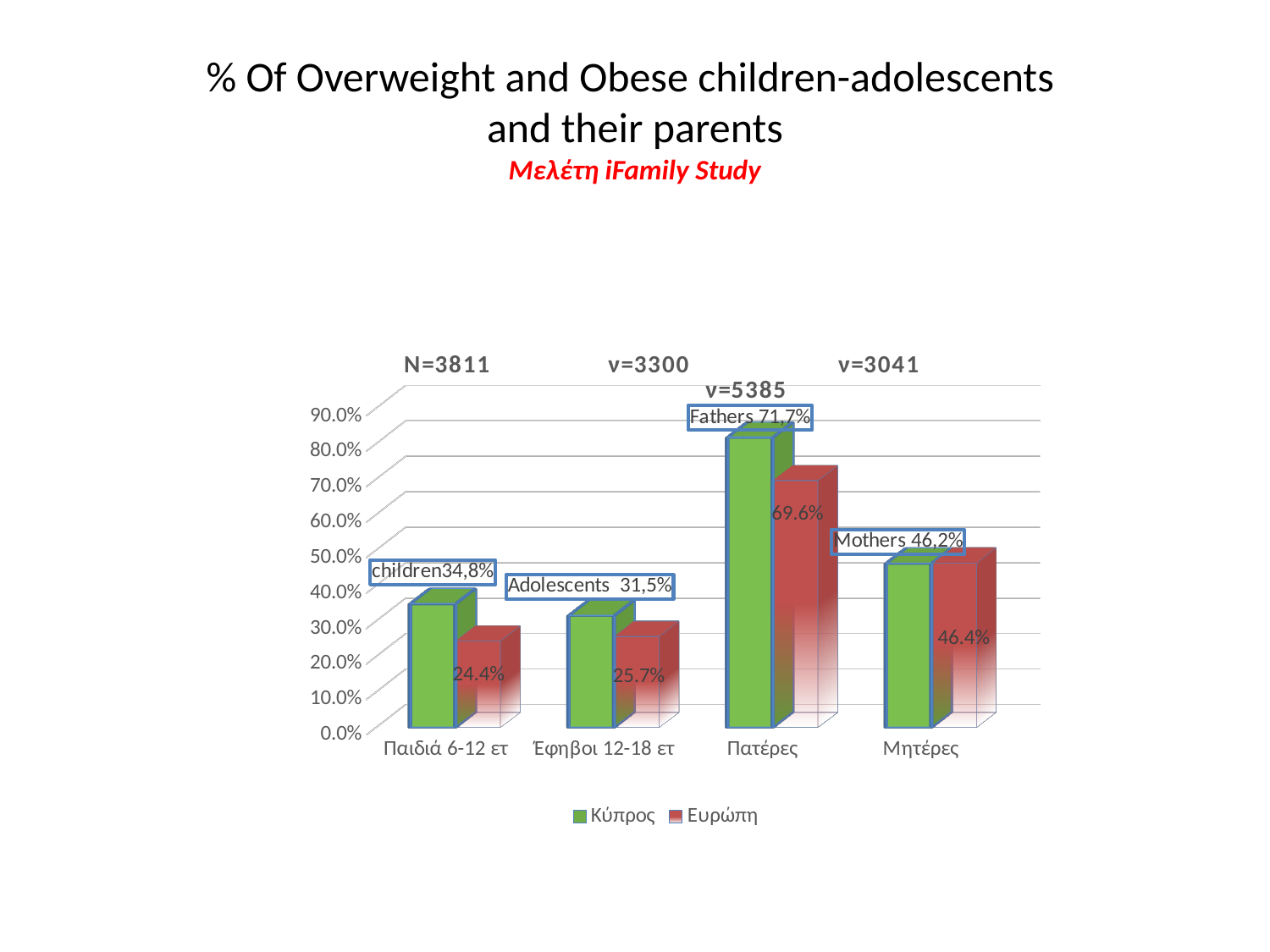
How many series does the legend list? 2 What is the difference between the Ευρώπη values for Πατέρες and Μητέρες? 23.2% Which category has the highest value for Ευρώπη? Πατέρες Which category has the lowest value for Ευρώπη? Παιδιά 6-12 ετ What is the value for Ευρώπη for Παιδιά 6-12 ετ? 24.4% What is the value for Ευρώπη for Πατέρες? 69.6% What is the value for Ευρώπη for Μητέρες? 46.4% What kind of chart is shown on the slide? Bar chart What is the value for Ευρώπη for Έφηβοι 12-18 ετ? 25.7% Is the Κύπρος value for Παιδιά 6-12 ετ greater or less than 40.0%? less How many categories are shown on the x axis? 4